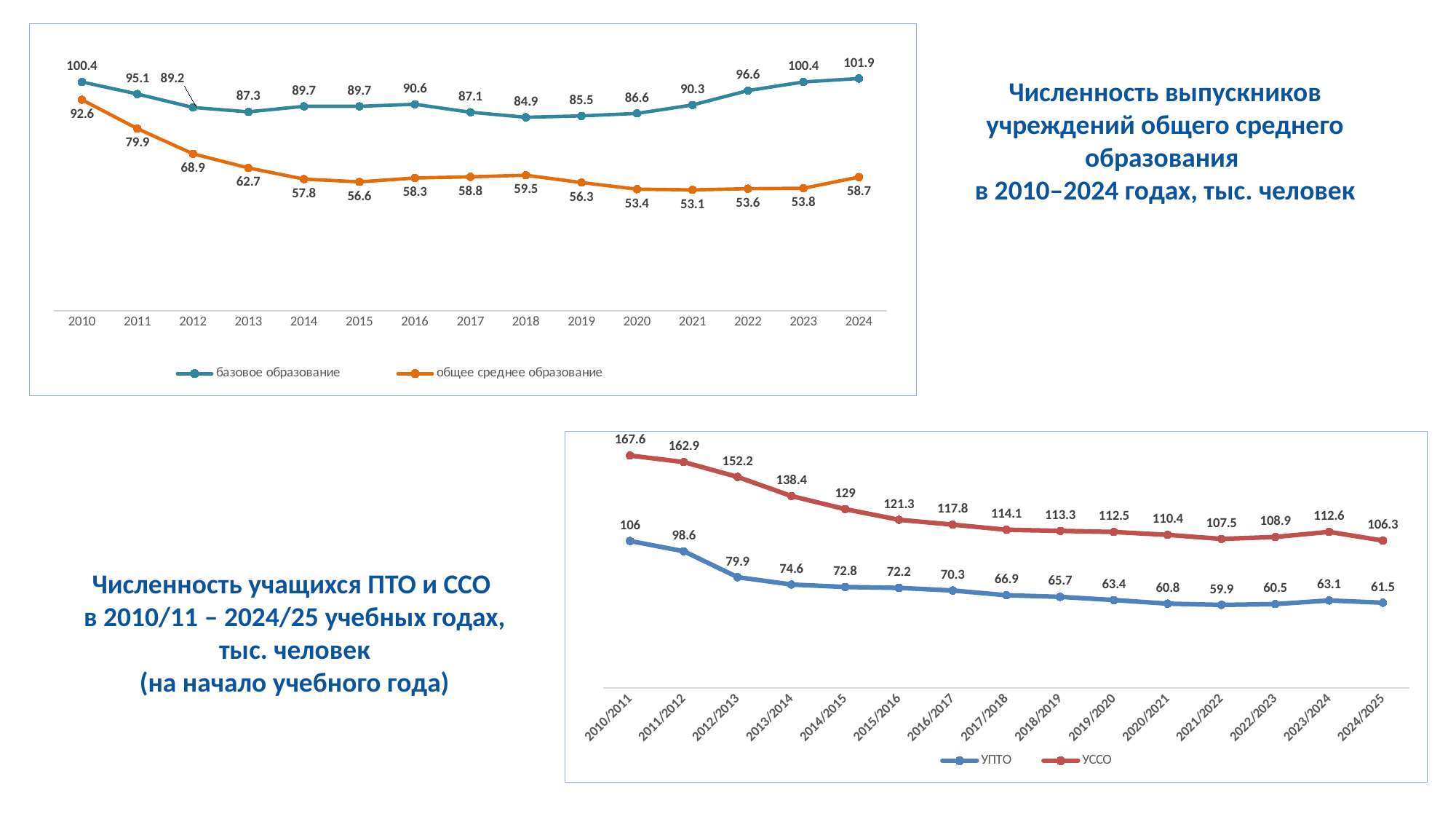
In the bottom chart (Численность учащихся ПТО и ССО), does the УССО series generally rise or fall from 2010/2011 to 2024/2025? Fall In the top chart (Численность выпускников учреждений общего среднего образования), what kind of chart is it? Line chart In the top chart (Численность выпускников учреждений общего среднего образования), how many series does the legend list? 2 In the top chart (Численность выпускников учреждений общего среднего образования), what is the value for общее среднее образование in 2015? 56.6 In the top chart (Численность выпускников учреждений общего среднего образования), in which year is the value for общее среднее образование lowest? 2021 In the bottom chart (Численность учащихся ПТО и ССО), what is the value for УПТО in 2024/2025? 61.5 In the top chart (Численность выпускников учреждений общего среднего образования), what is the difference between базовое образование and общее среднее образование in 2010? 7.8 In the bottom chart (Численность учащихся ПТО и ССО), how many academic years are shown on the x axis? 15 In the bottom chart (Численность учащихся ПТО и ССО), in which academic year is the value for УПТО lowest? 2021/2022 In the top chart (Численность выпускников учреждений общего среднего образования), what is the value for базовое образование in 2024? 101.9 In the bottom chart (Численность учащихся ПТО и ССО), what is the value for УССО in 2010/2011? 167.6 In the top chart (Численность выпускников учреждений общего среднего образования), in which year is the value for базовое образование highest? 2024